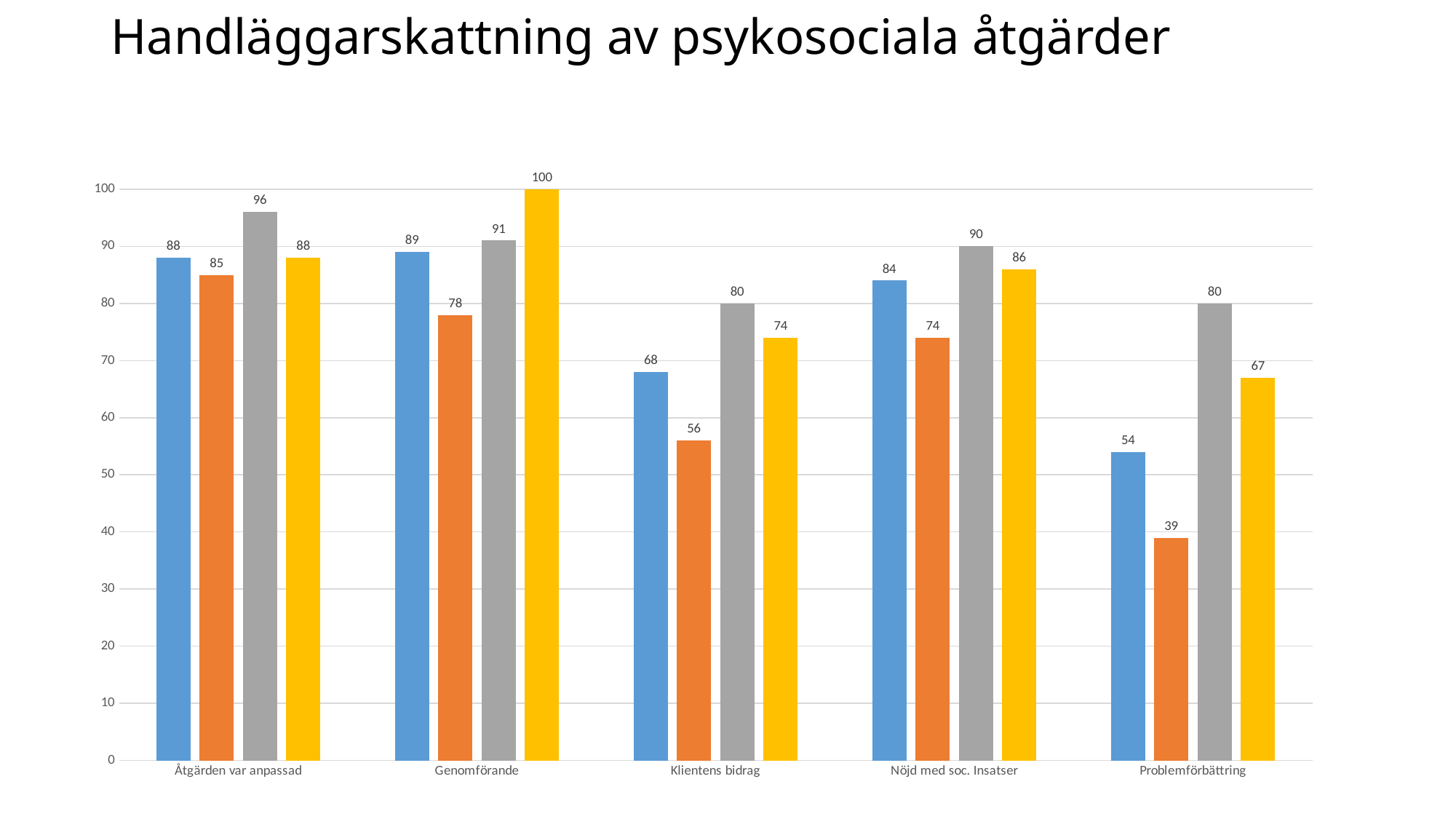
What is the value of the grey bar for Nöjd med soc. Insatser? 90 What is the value of the blue bar for Genomförande? 89 What is the difference between the yellow bar and the blue bar for Genomförande? 11 What is the value of the orange bar for Problemförbättring? 39 How many categories are shown on the x axis? 5 What is the title of the slide? Handläggarskattning av psykosociala åtgärder What is the value of the yellow bar for Klientens bidrag? 74 What is the difference between the grey bar and the orange bar for Problemförbättring? 41 Which category has the lowest orange bar? Problemförbättring Which is larger for Klientens bidrag, the blue bar or the grey bar? the grey bar What kind of chart is shown on the slide? bar chart Which category has the highest yellow bar? Genomförande